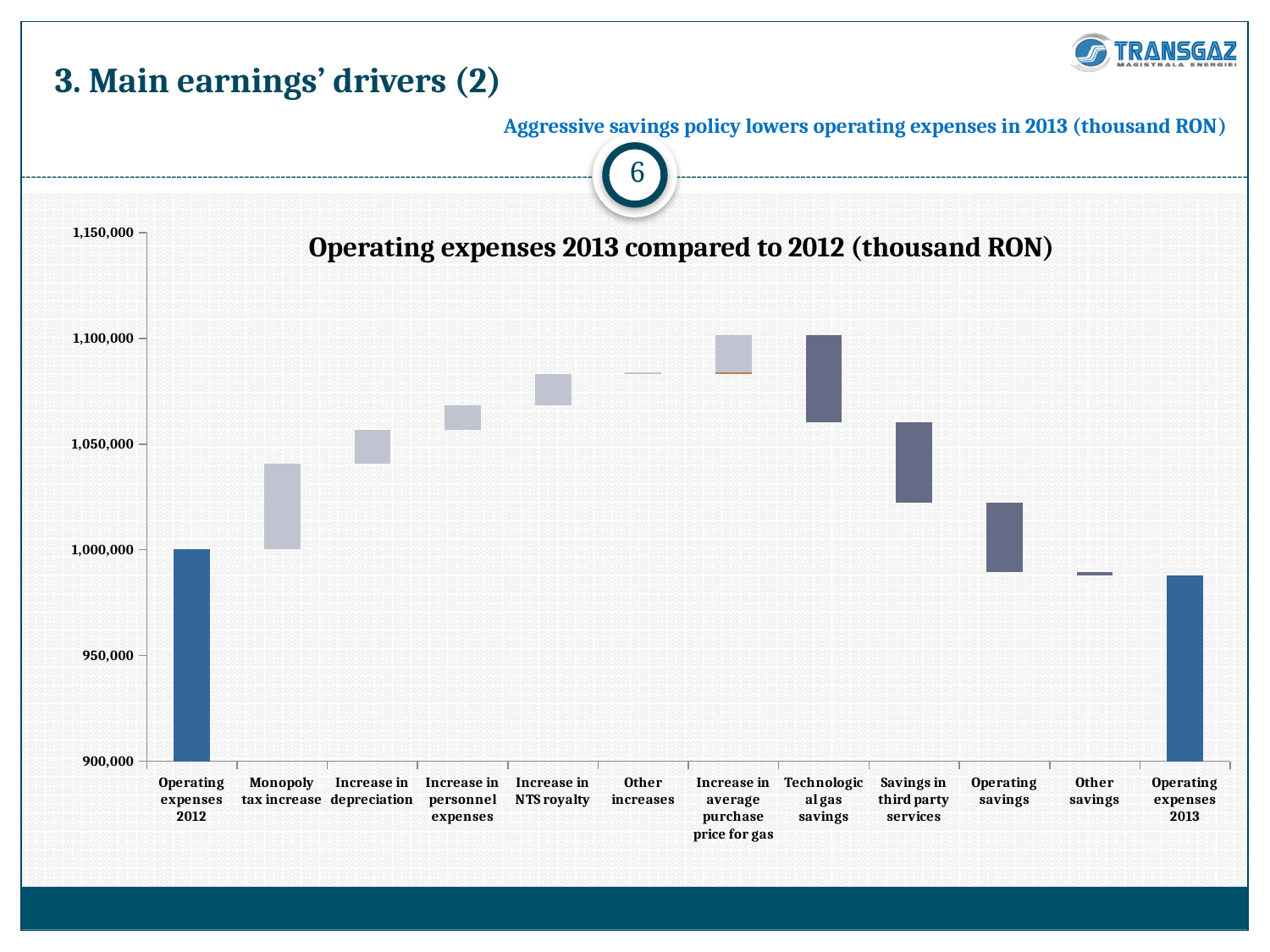
Do the cumulative operating expenses rise or fall across the savings items from Technological gas savings to Other savings? fall Which increase item contributes the smallest rise in operating expenses? Other increases Which increase item contributes the largest rise in operating expenses? Monopoly tax increase Which is larger, Operating expenses 2012 or Operating expenses 2013? Operating expenses 2012 How many categories are shown along the x axis of the chart? 12 Which savings item contributes the smallest reduction in operating expenses? Other savings Is the value for Operating expenses 2013 greater or less than 1,000,000? less What is the highest value shown on the y axis of the chart? 1,150,000 What kind of chart is shown on the slide? bar chart (waterfall) What is the title of the chart? Operating expenses 2013 compared to 2012 (thousand RON)